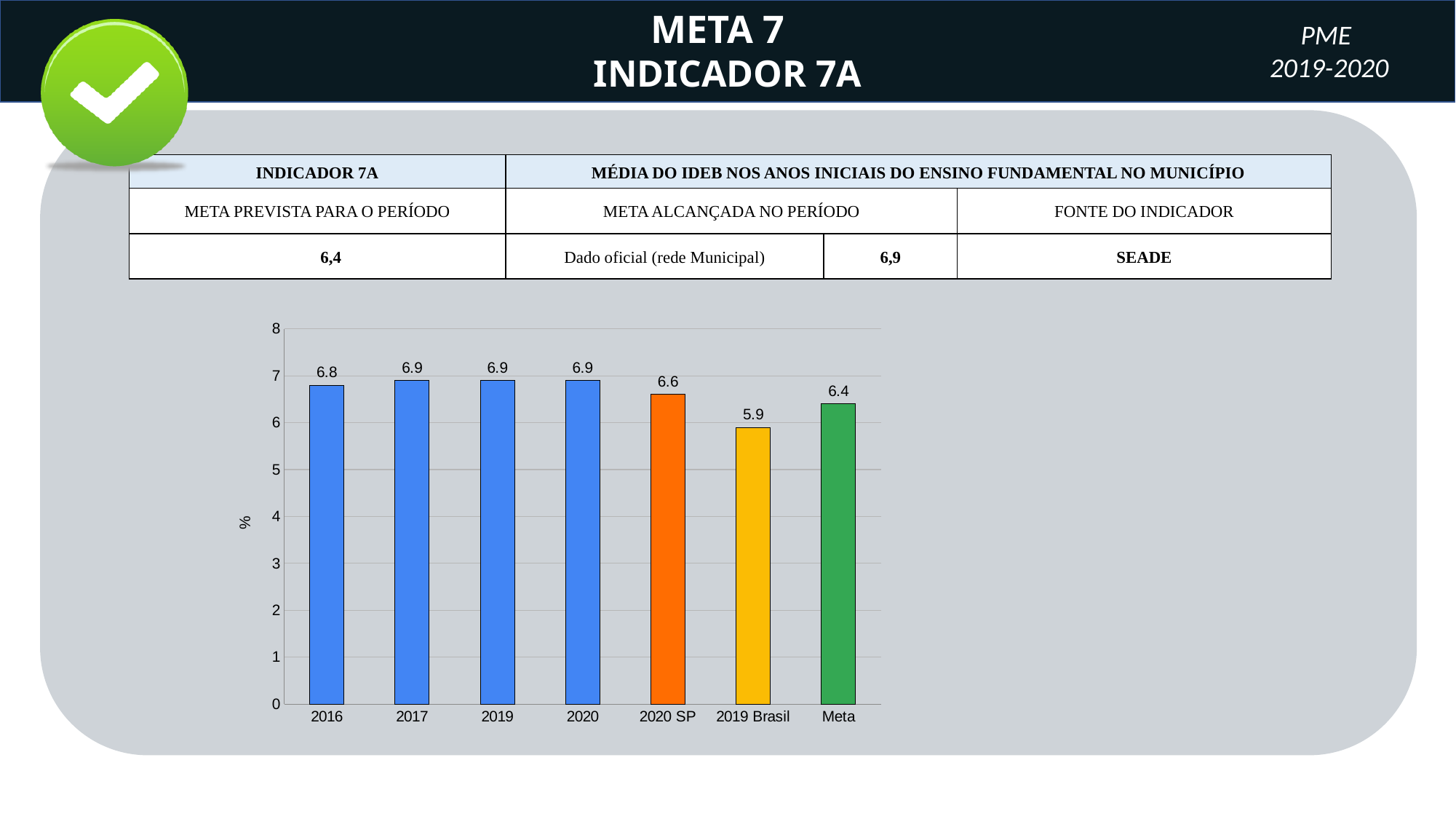
What is the difference between the value for 2020 and the value for Meta? 0.5 What is the value for 2019 Brasil in the bar chart? 5.9 Which category has the lowest value in the bar chart? 2019 Brasil What kind of chart is shown on the slide? bar chart Which is larger, the value for 2016 or the value for 2017? 2017 What is the difference between the value for 2020 SP and the value for 2019 Brasil? 0.7 What is the label on the vertical axis of the chart? % What is the value for 2016 in the bar chart? 6.8 Is the value for 2019 Brasil greater or less than 6? less What is the value for Meta in the bar chart? 6.4 How many bars are shown in the bar chart? 7 What is the value for 2020 SP in the bar chart? 6.6